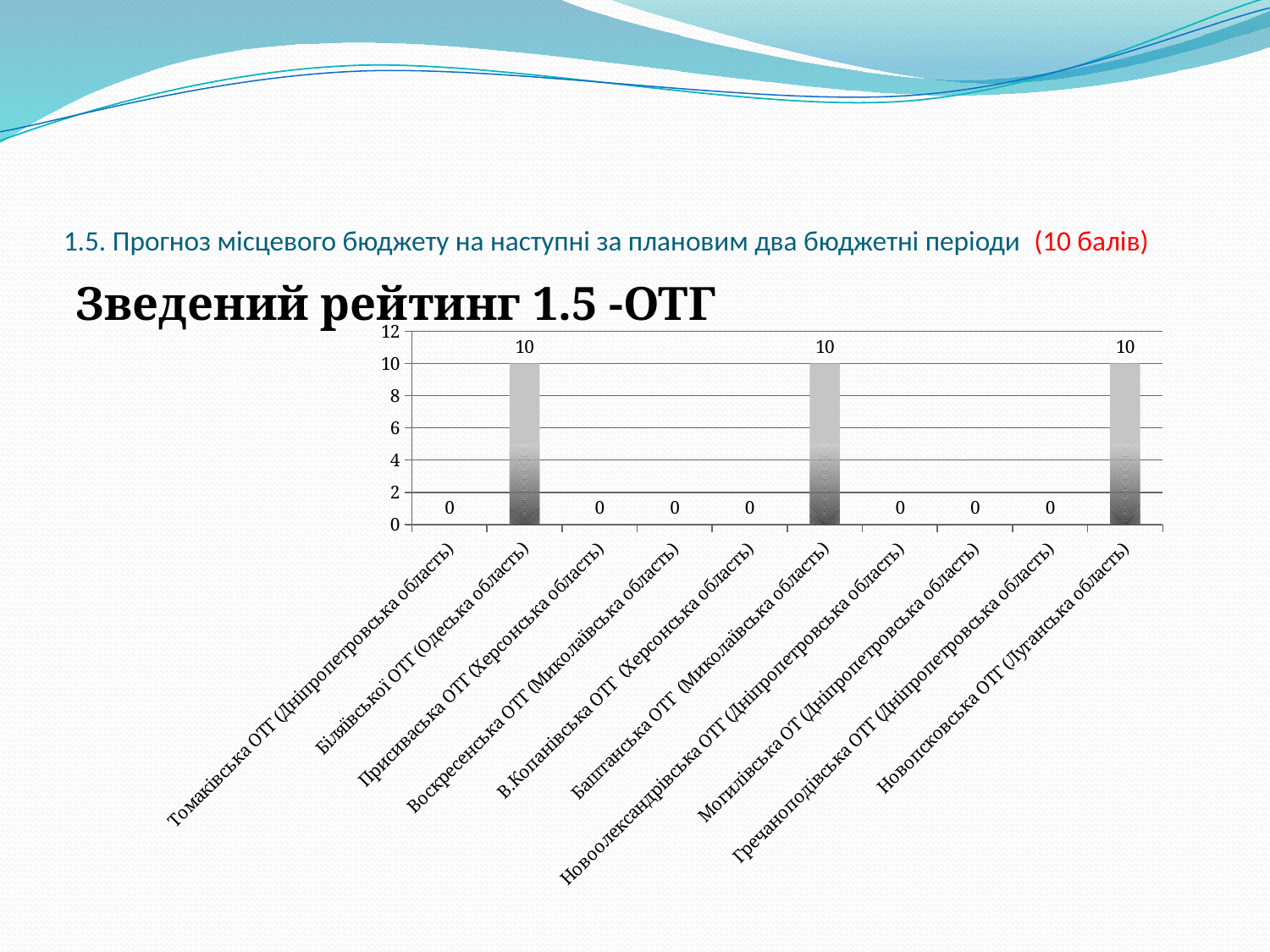
What is the value for Присиваська ОТГ (Херсонська область)? 0 Which is larger, the value for Новопсковська ОТГ (Луганська область) or the value for Гречанопідівська ОТГ (Дніпропетровська область)? Новопсковська ОТГ (Луганська область) What is the value for Баштанська ОТГ (Миколаївська область)? 10 How many categories have a value of 10? 3 What kind of chart is shown on the slide? Bar chart What is the maximum value shown on the y axis of the chart? 12 What is the value for Біляївської ОТГ (Одеська область)? 10 What is the value for Новопсковська ОТГ (Луганська область)? 10 What is the value for Томаківська ОТГ (Дніпропетровська область)? 0 How many categories are shown on the x axis of the chart? 10 What is the title of the chart? Зведений рейтинг 1.5 -ОТГ What is the difference between the values for Баштанська ОТГ (Миколаївська область) and Воскресенська ОТГ (Миколаївська область)? 10